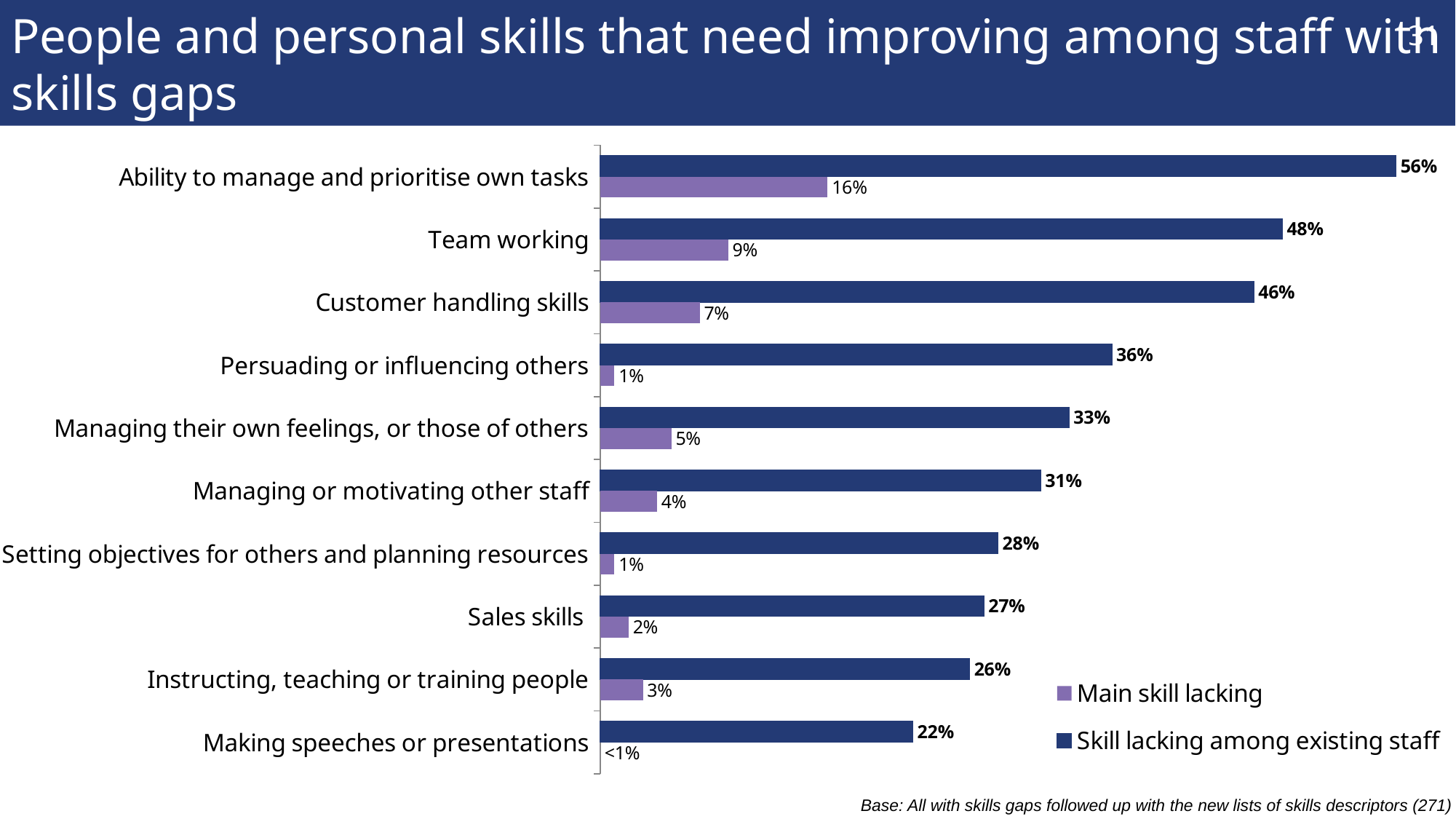
What is the base stated at the bottom of the slide? All with skills gaps followed up with the new lists of skills descriptors (271) Which category has the highest value for 'Skill lacking among existing staff'? Ability to manage and prioritise own tasks How many skill categories are shown in the chart? 10 What is the difference between the 'Skill lacking among existing staff' values for Team working and Customer handling skills? 2% What is the value for 'Main skill lacking' for Managing their own feelings, or those of others? 5% What is the value for 'Skill lacking among existing staff' for Ability to manage and prioritise own tasks? 56% What kind of chart is shown on the slide? Bar chart What is the value for 'Main skill lacking' for Team working? 9% How many series does the legend list? 2 What is the value for 'Skill lacking among existing staff' for Making speeches or presentations? 22% Which category has the lowest value for 'Skill lacking among existing staff'? Making speeches or presentations Which is larger: the 'Main skill lacking' value for Customer handling skills or for Managing or motivating other staff? Customer handling skills